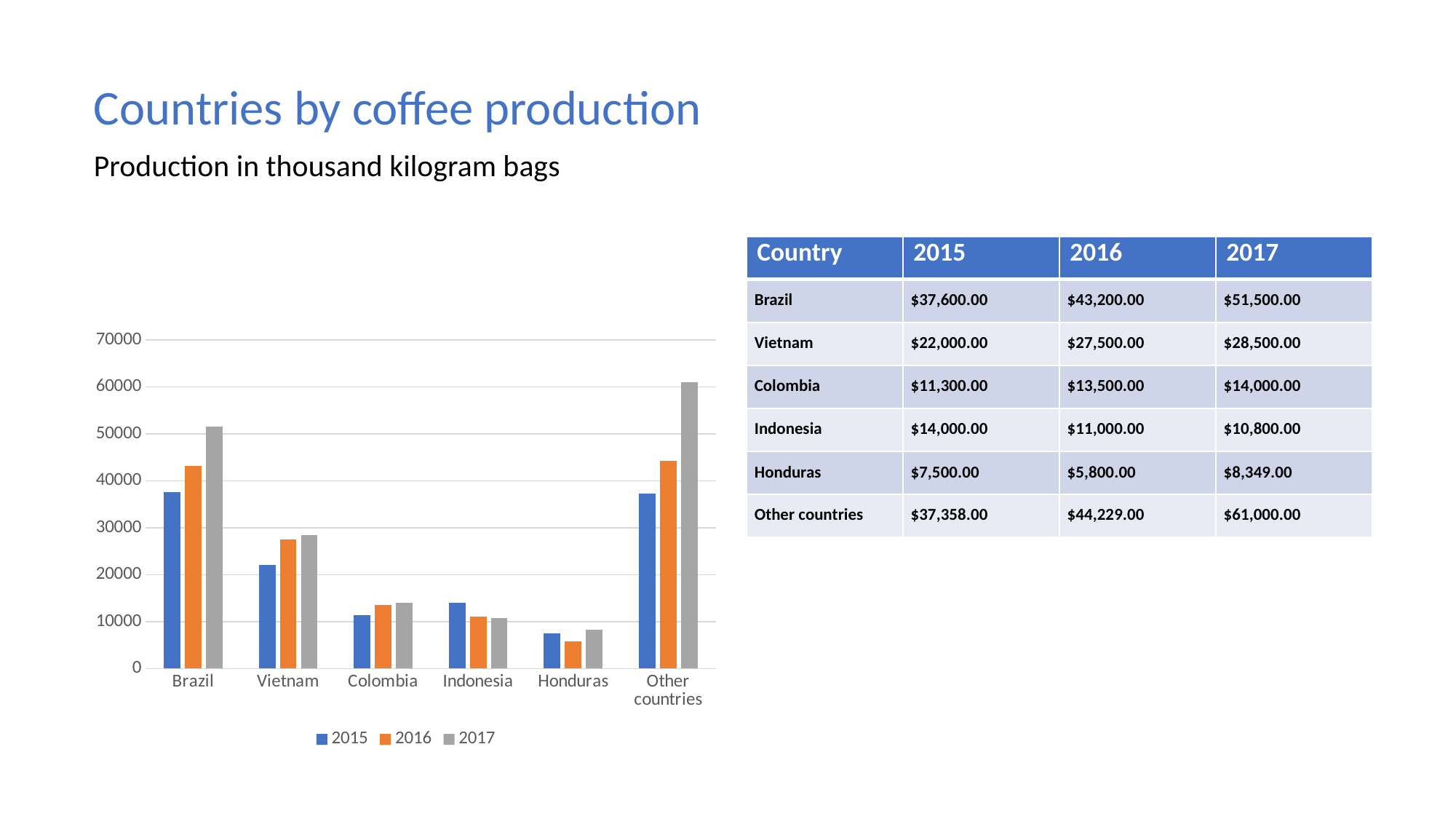
What is the difference between Brazil's 2017 and 2015 values? $13,900.00 Which category has the lowest 2016 value? Honduras What is the 2016 value for Honduras? $5,800.00 Is the 2017 value for Other countries greater or less than 60000? greater Do Indonesia's values rise or fall from 2015 to 2017? fall How many series does the chart legend list? 3 What is the 2017 value for Brazil? $51,500.00 What kind of chart is shown on the slide? bar chart Which category has the highest 2017 value? Other countries How many countries/categories are shown on the x axis of the chart? 6 Which is larger, Indonesia's 2015 value or Colombia's 2015 value? Indonesia's 2015 value What is the 2015 value for Vietnam? $22,000.00